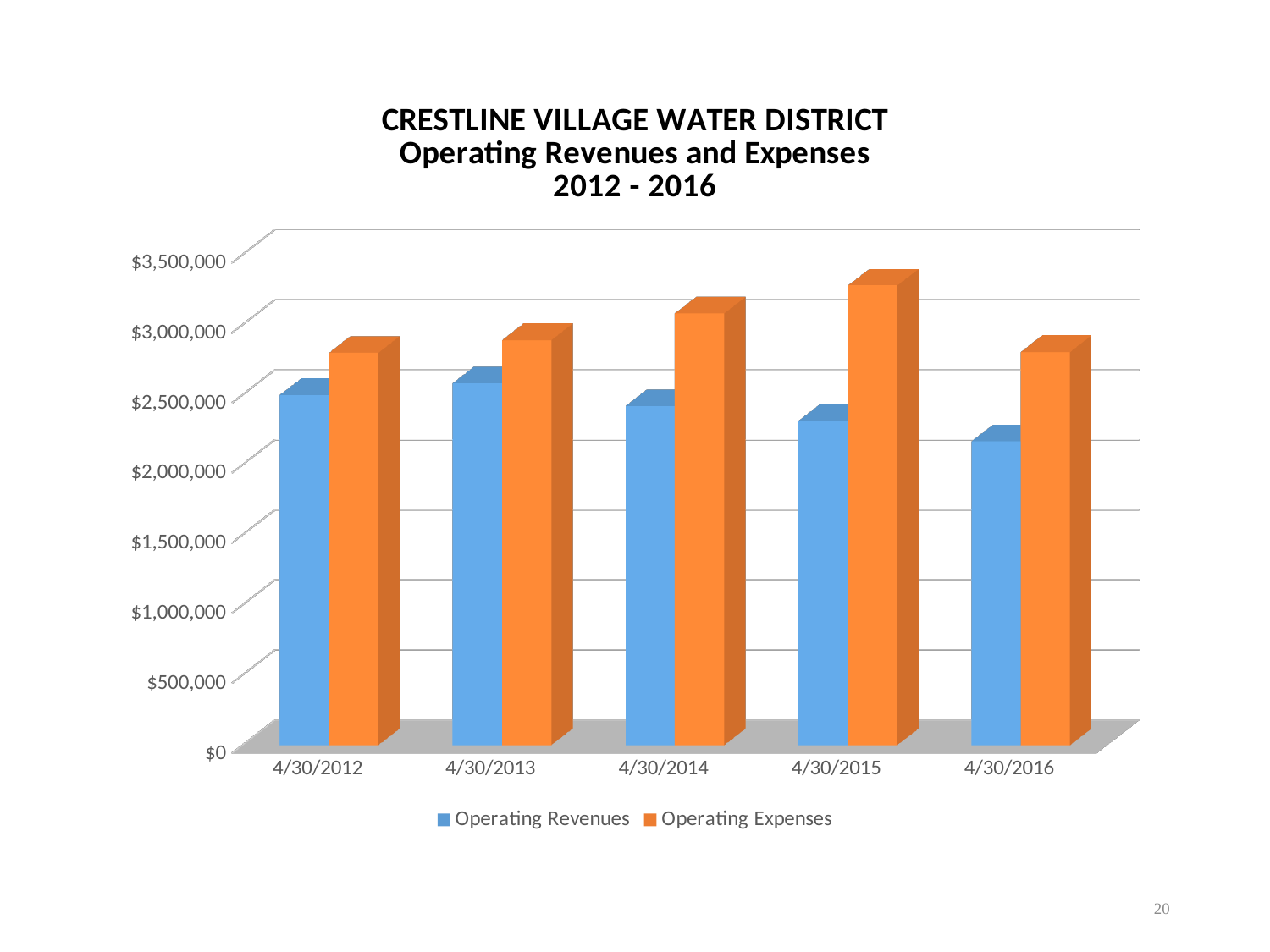
What kind of chart is shown on the slide? Bar chart How many dates are shown along the x axis? 5 Is the value for Operating Revenues on 4/30/2016 greater or less than $2,500,000? less How many series does the legend list? 2 Is the value for Operating Expenses on 4/30/2015 greater or less than $3,000,000? greater On which date are Operating Expenses highest? 4/30/2015 Do Operating Expenses rise or fall from 4/30/2012 to 4/30/2015? rise Which colour represents Operating Expenses in the chart? Orange On which date are Operating Revenues lowest? 4/30/2016 Is the value for Operating Expenses on 4/30/2012 greater or less than $3,000,000? less On 4/30/2015, which is larger: Operating Revenues or Operating Expenses? Operating Expenses Which is larger: Operating Revenues on 4/30/2012 or on 4/30/2016? 4/30/2012